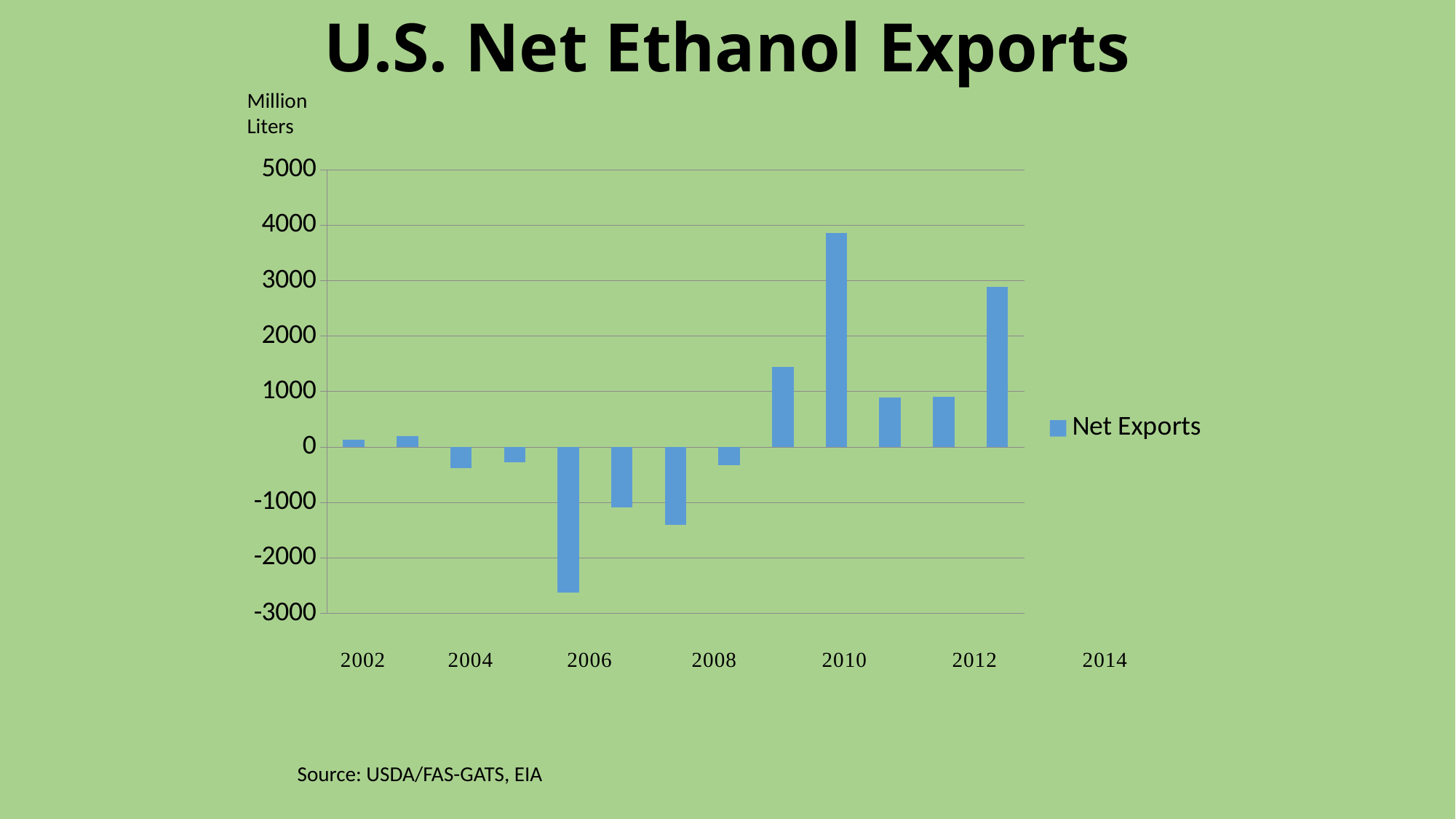
Is the value of the last bar on the right greater or less than 2000? greater How many bars in the chart have negative values? 6 Is the value of the tallest bar greater or less than 3000? greater Which is larger, the tallest bar or the last bar on the right? the tallest bar What kind of chart is shown on the slide? bar chart Is the value of the first bar (2002) greater or less than 1000? less What unit is given for the vertical axis? Million Liters How many series does the legend list? 1 How many bars are plotted in the chart? 13 What is the name of the series shown in the legend? Net Exports What is the title of the chart? U.S. Net Ethanol Exports